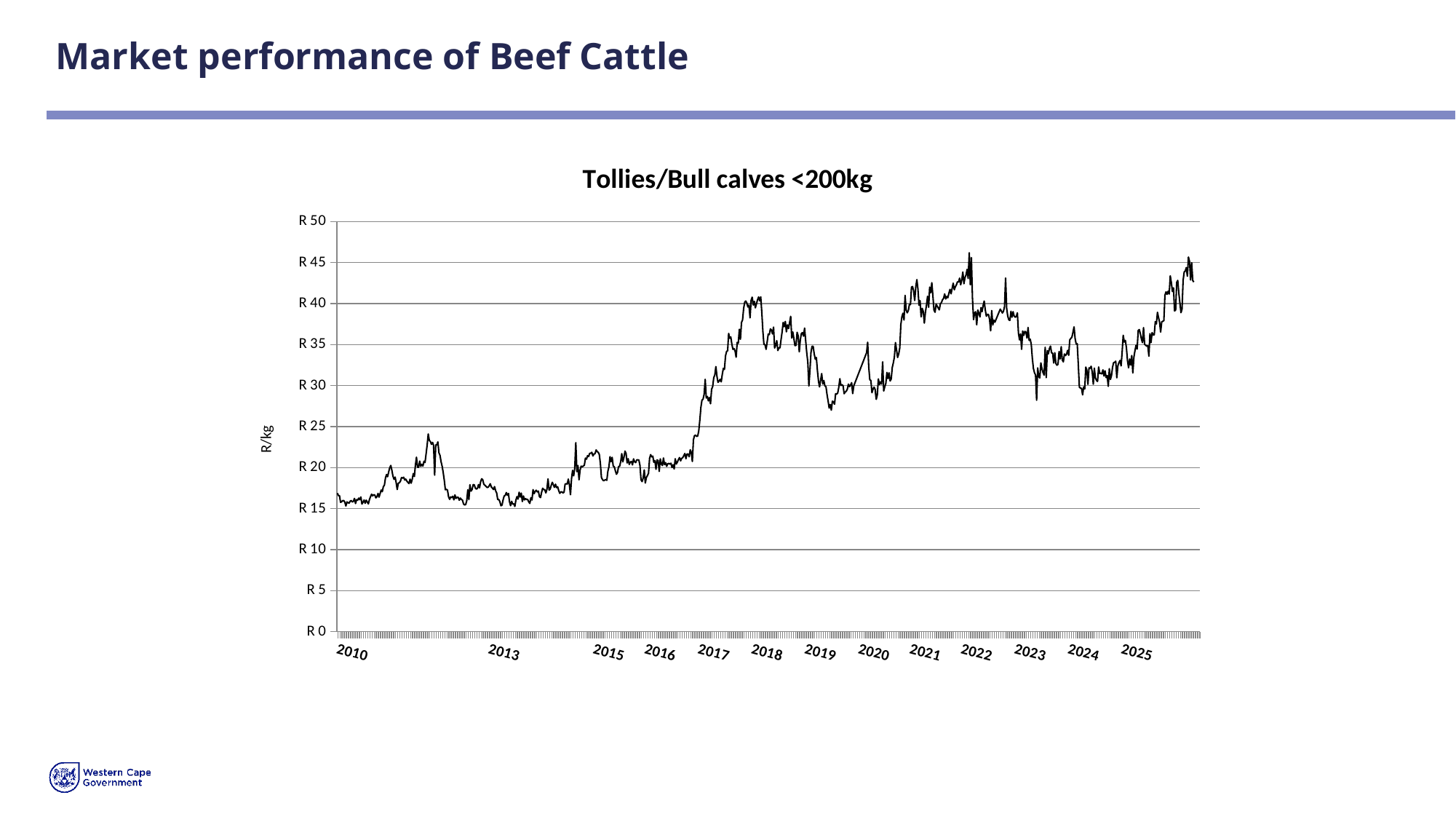
What kind of chart is shown on the slide? line chart Overall, do the values rise or fall from 2010 to 2025? rise Is the lowest value around 2019 greater or less than R 30? less Is the value around 2016 higher or lower than the value around 2021? lower What is the title of the chart? Tollies/Bull calves <200kg Is the value at the start of 2010 greater or less than R 20? less What is the label on the vertical axis of the chart? R/kg Is the value around 2018 greater or less than R 30? greater Do the values rise or fall from the 2022 peak to 2023? fall